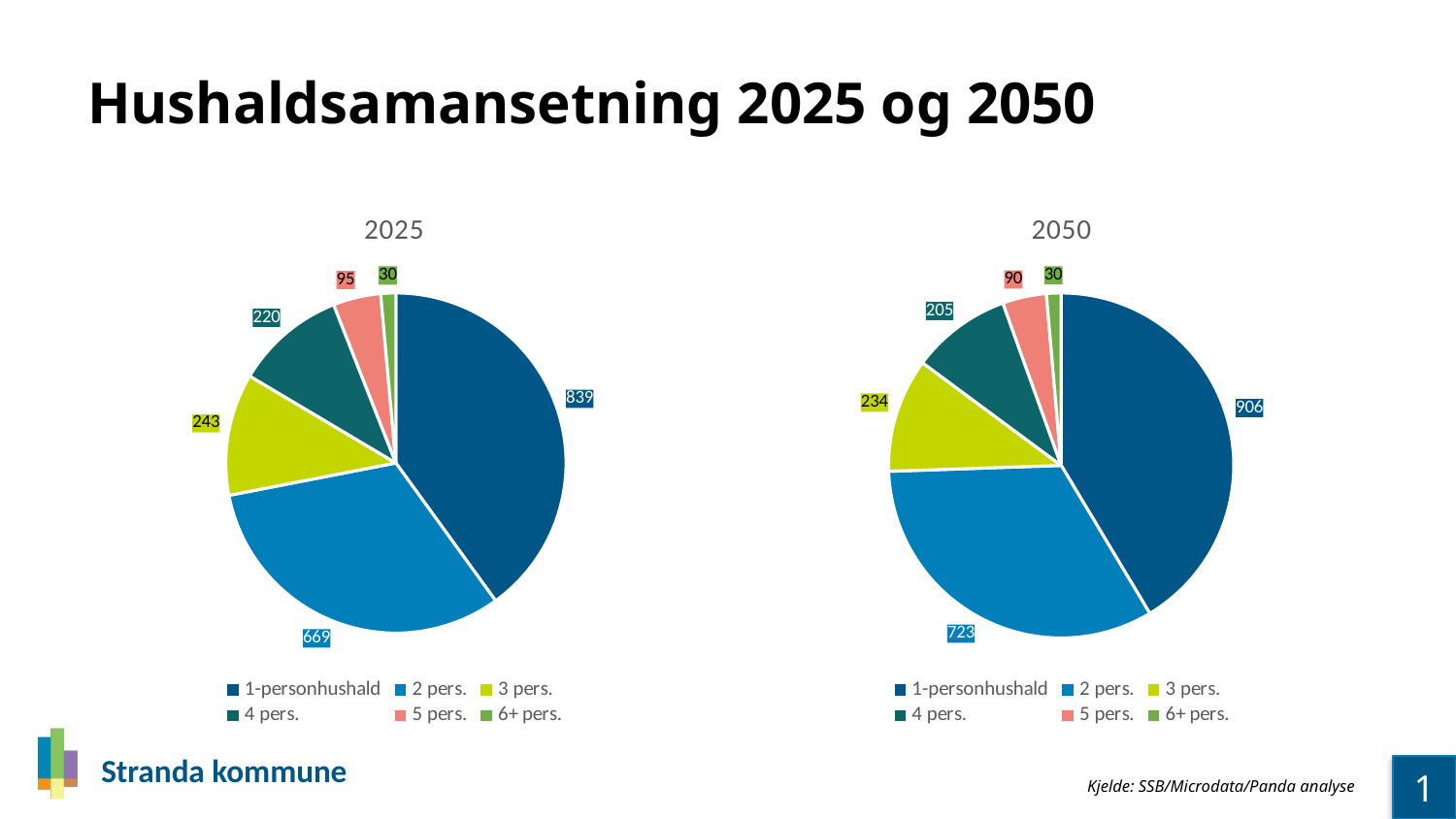
In the 2050 chart, what is the value for 2 pers.? 723 In the 2050 chart, what is the difference between the 3 pers. and 4 pers. values? 29 In the 2025 chart, which category has the smallest slice? 6+ pers. Which is larger: the 5 pers. value in the 2025 chart or in the 2050 chart? 2025 (95) What is the difference between the 1-personhushald value in the 2050 chart and in the 2025 chart? 67 How many slices does the 2025 pie chart have? 6 In the 2025 chart, what is the value for 4 pers.? 220 What kind of charts are shown on the slide? Pie charts In the 2050 chart, which category has the largest slice? 1-personhushald In the 2025 chart, what is the value for 1-personhushald? 839 How many series does the legend of the 2050 chart list? 6 What is the total of all slices in the 2025 chart? 2096